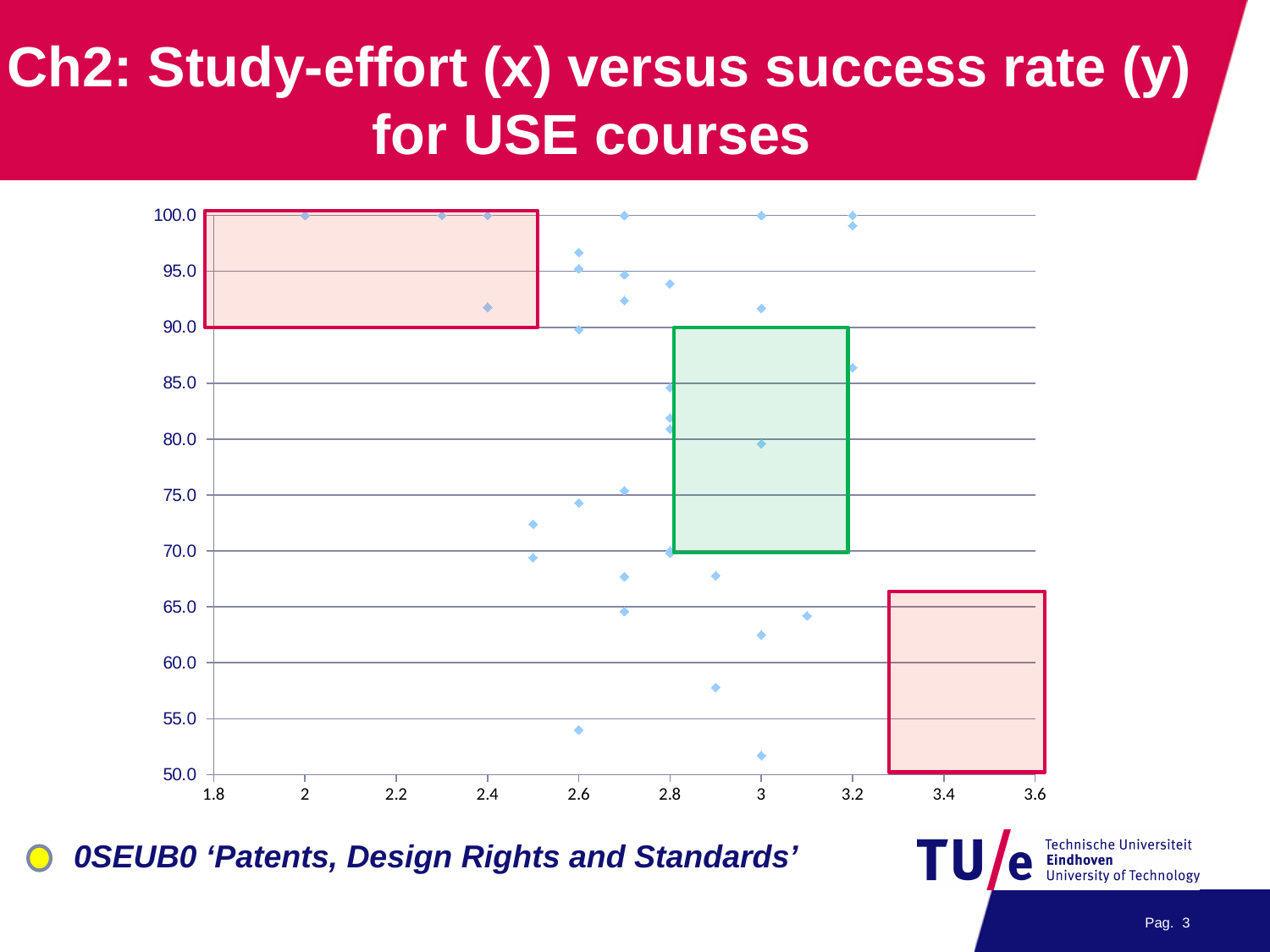
Is the lowest plotted success rate greater or less than 55.0? less What kind of chart is shown on the slide? scatter plot What are the lowest and highest values shown on the y axis of the chart? 50.0 and 100.0 What is the title of the chart on the slide? Ch2: Study-effort (x) versus success rate (y) for USE courses Is the largest study-effort (x) value among the plotted points greater or less than 3.4? less Is the highest plotted success rate greater or less than 95.0? greater